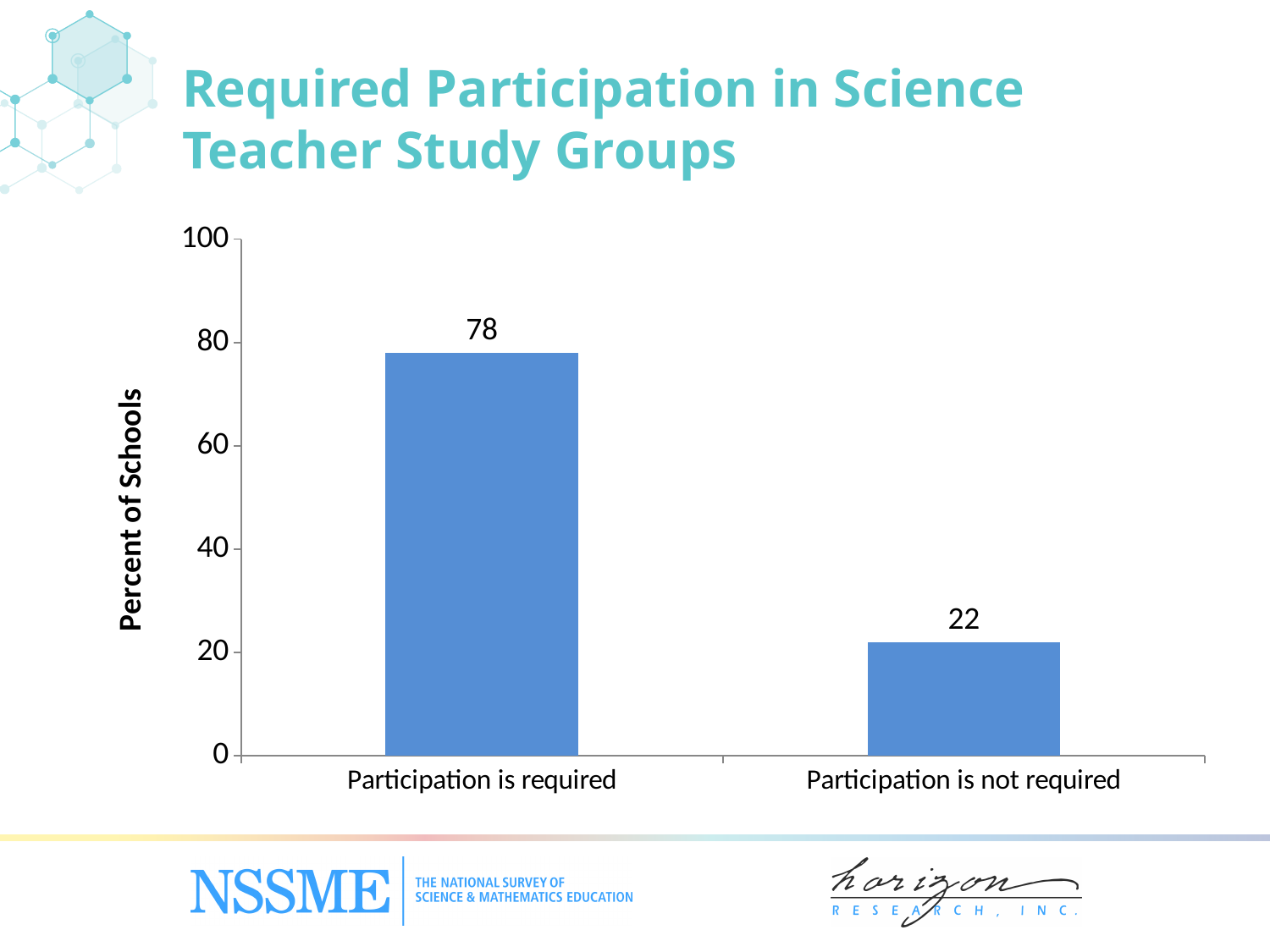
What is the value for "Participation is required"? 78 Is the value for "Participation is required" greater or less than 60? greater What is the title of the chart? Required Participation in Science Teacher Study Groups Which is larger, the value for "Participation is required" or "Participation is not required"? Participation is required What is the difference between the values for "Participation is required" and "Participation is not required"? 56 What is the value for "Participation is not required"? 22 How many categories are shown on the chart? 2 Which category has the highest value? Participation is required Which category has the lowest value? Participation is not required What kind of chart is shown on the slide? bar chart Is the value for "Participation is not required" greater or less than 40? less What is the label on the vertical axis? Percent of Schools